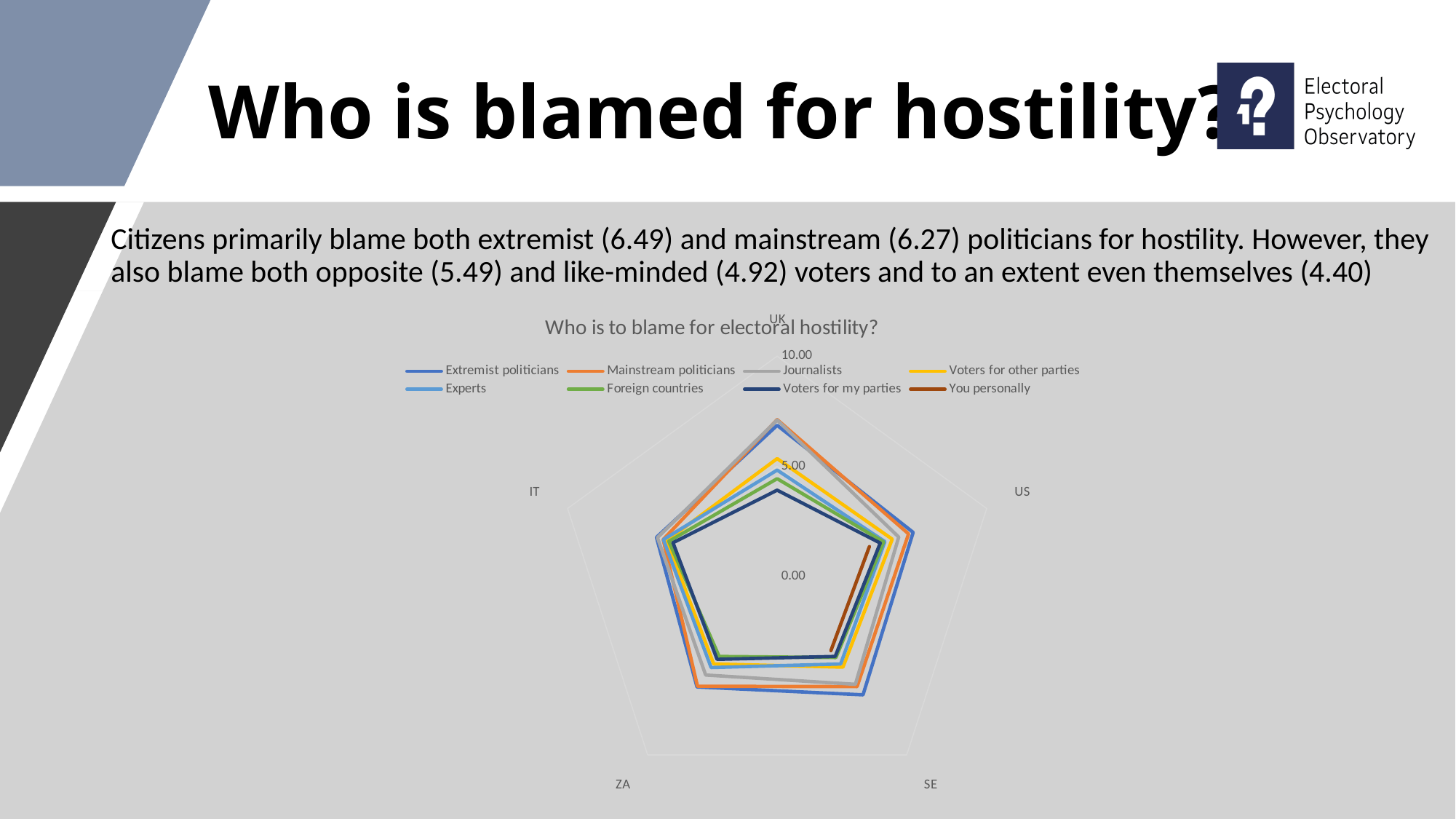
How many countries (axes) are plotted on the radar chart? 5 Is the value for Extremist politicians in the US greater or less than 5.00? greater What is the maximum value shown on the chart's radial axis? 10.00 Which countries are shown as the axes of the radar chart? UK, US, SE, ZA, IT What kind of chart is shown on the slide? Radar chart What is the title of the chart? Who is to blame for electoral hostility? Is the value for Extremist politicians in the UK greater or less than 5.00? greater Is the value for Voters for my parties in the UK greater or less than 5.00? less How many series does the chart legend list? 8